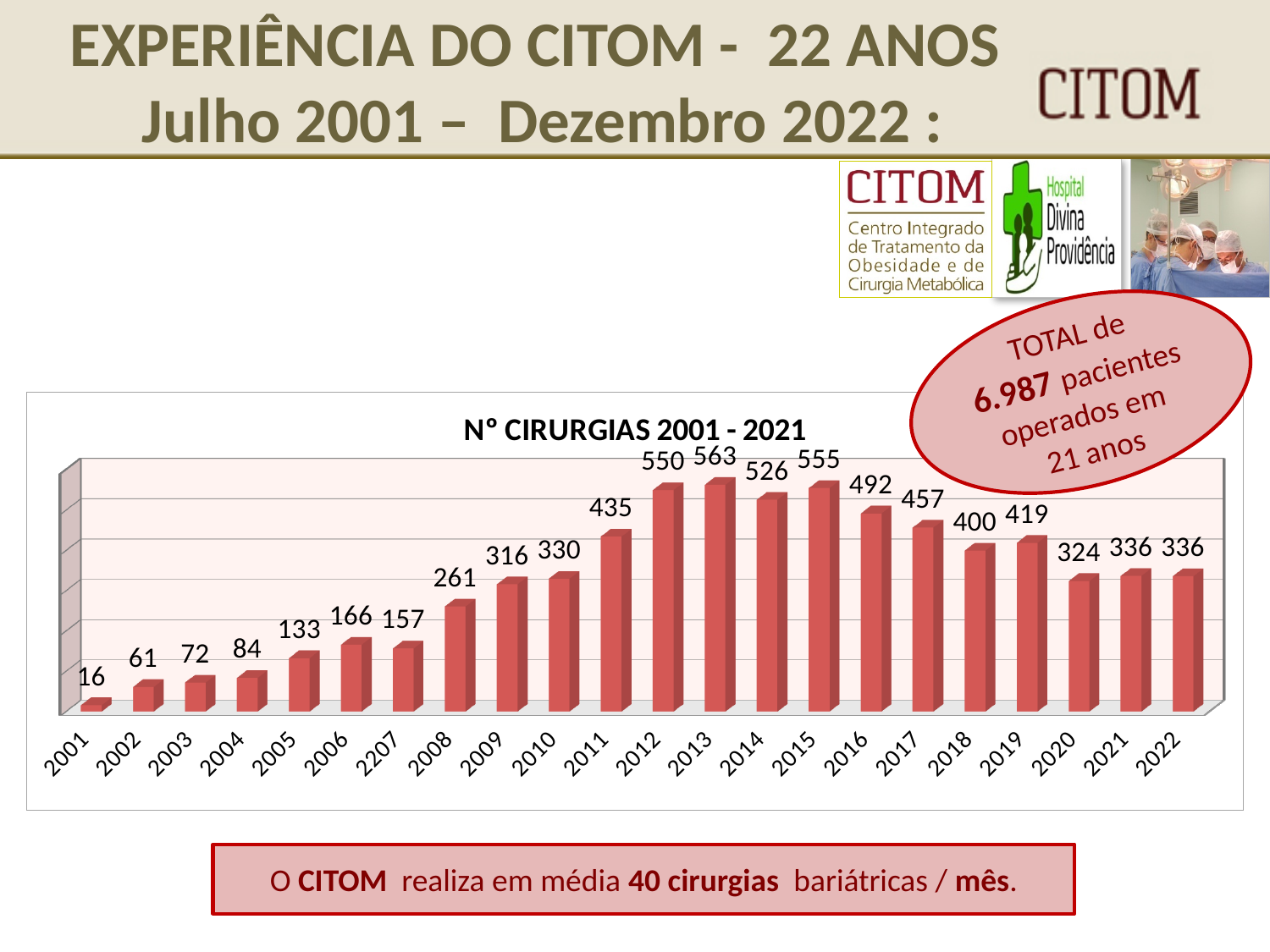
Which year has the highest value in the chart? 2013 What kind of chart is shown on the slide? bar chart What is the difference between the values for 2019 and 2022? 83 What is the value for 2018 in the chart? 400 Which year has the lowest value in the chart? 2001 Which is larger, the value for 2015 or the value for 2014? 2015 How many years (bars) are shown in the chart? 22 What is the difference between the values for 2013 and 2012? 13 What is the title of the chart? Nº CIRURGIAS 2001 - 2021 What is the value for 2013 in the chart? 563 Do the values rise or fall from 2001 to 2013? rise What is the value for 2001 in the chart? 16